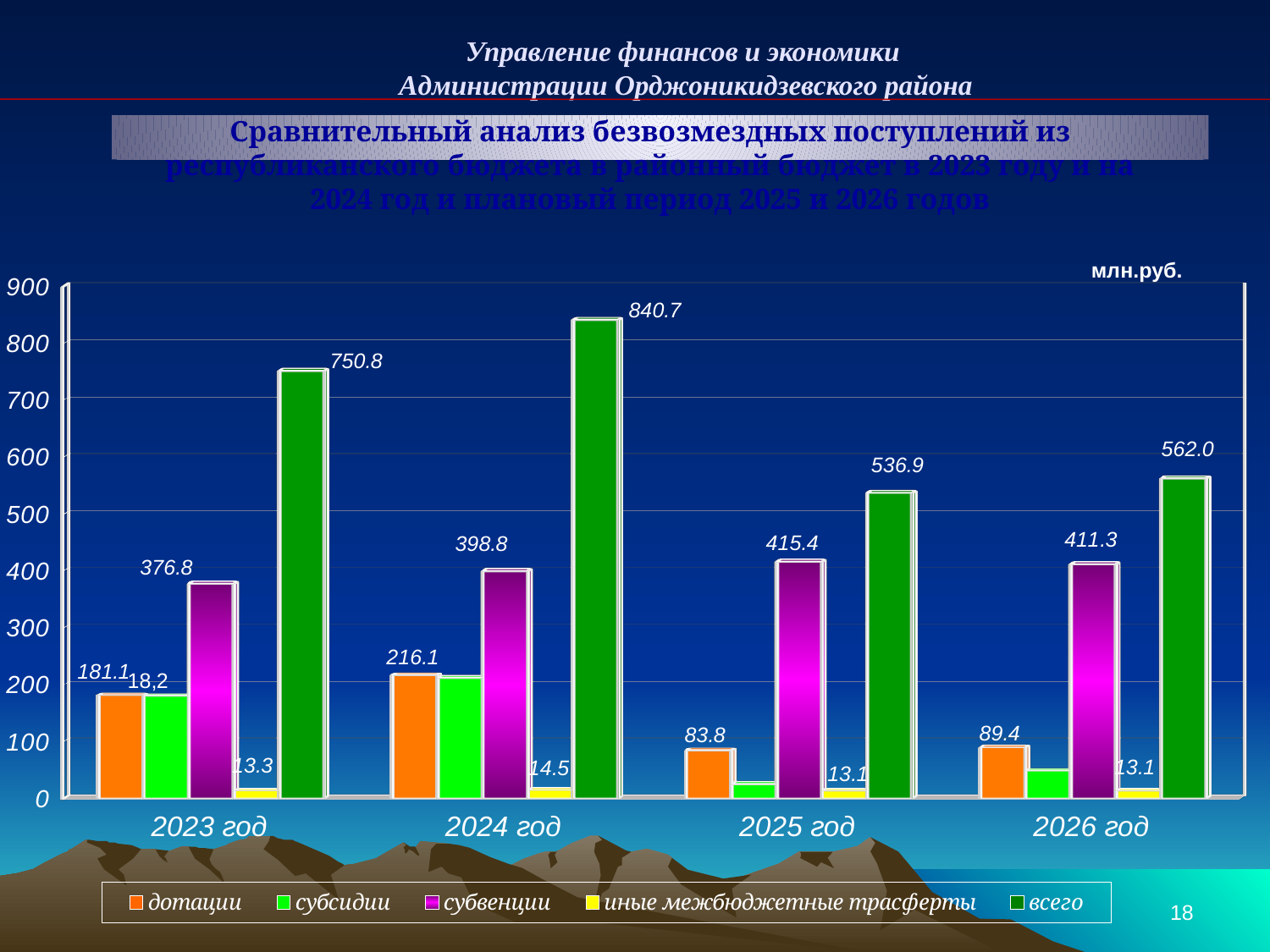
Is the value for субсидии in 2025 год greater or less than 100? less What is the difference between всего for 2024 год and всего for 2023 год? 89.9 What is the value of субвенции for 2025 год? 415.4 How many years are shown on the x axis? 4 Which year has the lowest value for всего? 2025 год What is the value of всего for 2024 год? 840.7 How many series does the legend list? 5 Which year has the highest value for всего? 2024 год What is the value of иные межбюджетные трасферты for 2024 год? 14.5 Which is larger: субвенции for 2025 год or субвенции for 2026 год? 2025 год What is the value of дотации for 2023 год? 181.1 What unit is indicated above the chart? млн.руб.